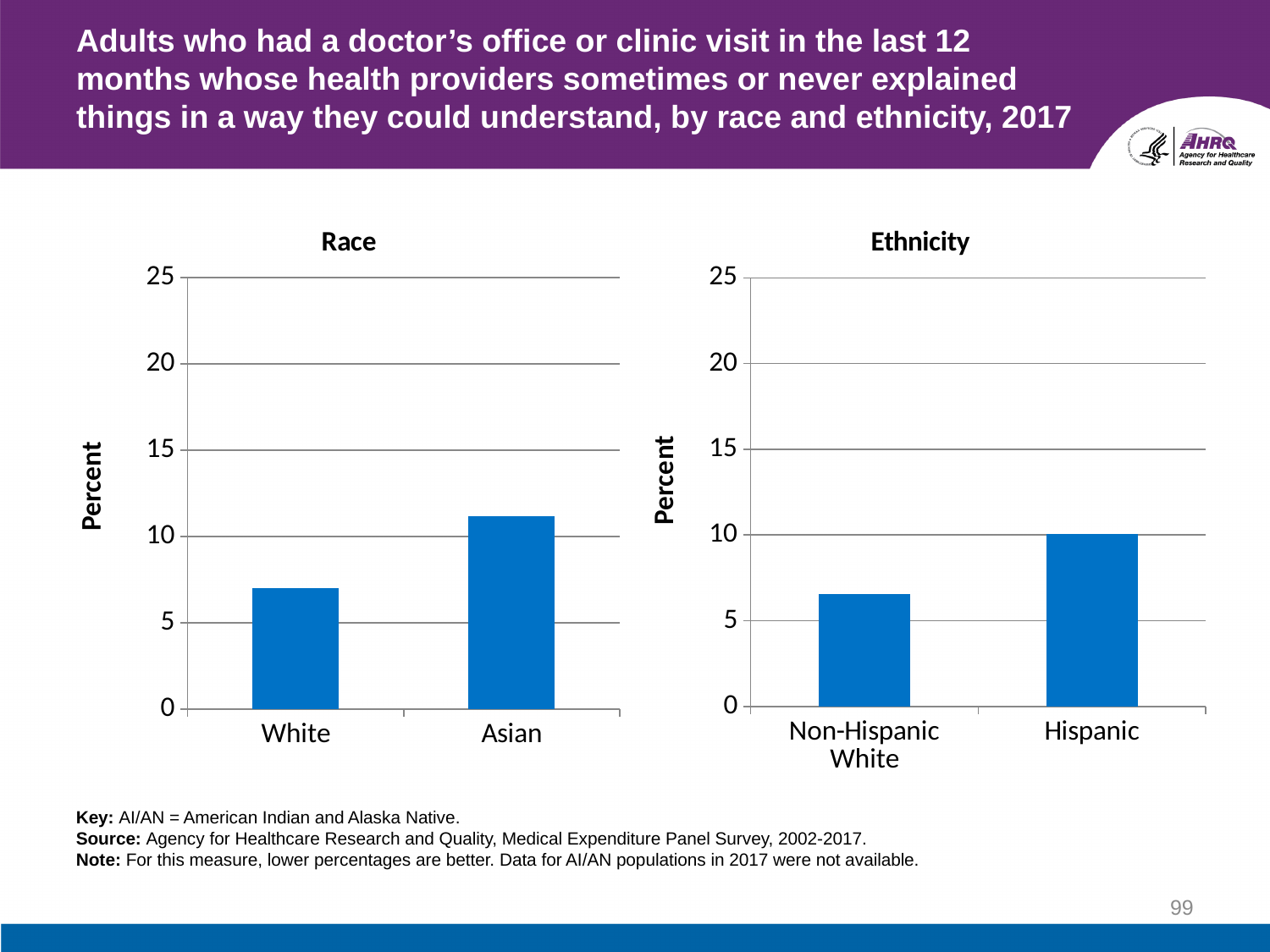
In the Race chart, which category has the higher value? Asian In the Ethnicity chart, is the value for Hispanic greater or less than 15? less What kind of chart is the Ethnicity chart? Bar chart In the Ethnicity chart, which category has the lower value? Non-Hispanic White How many categories are shown in the Race chart? 2 In the Ethnicity chart, is the value for Non-Hispanic White greater or less than 5? greater In the Ethnicity chart, which category has the higher value? Hispanic In the Race chart, which category has the lower value? White What is the label on the vertical axis of the Race chart? Percent In the Race chart, is the value for White greater or less than 10? less How many categories are shown in the Ethnicity chart? 2